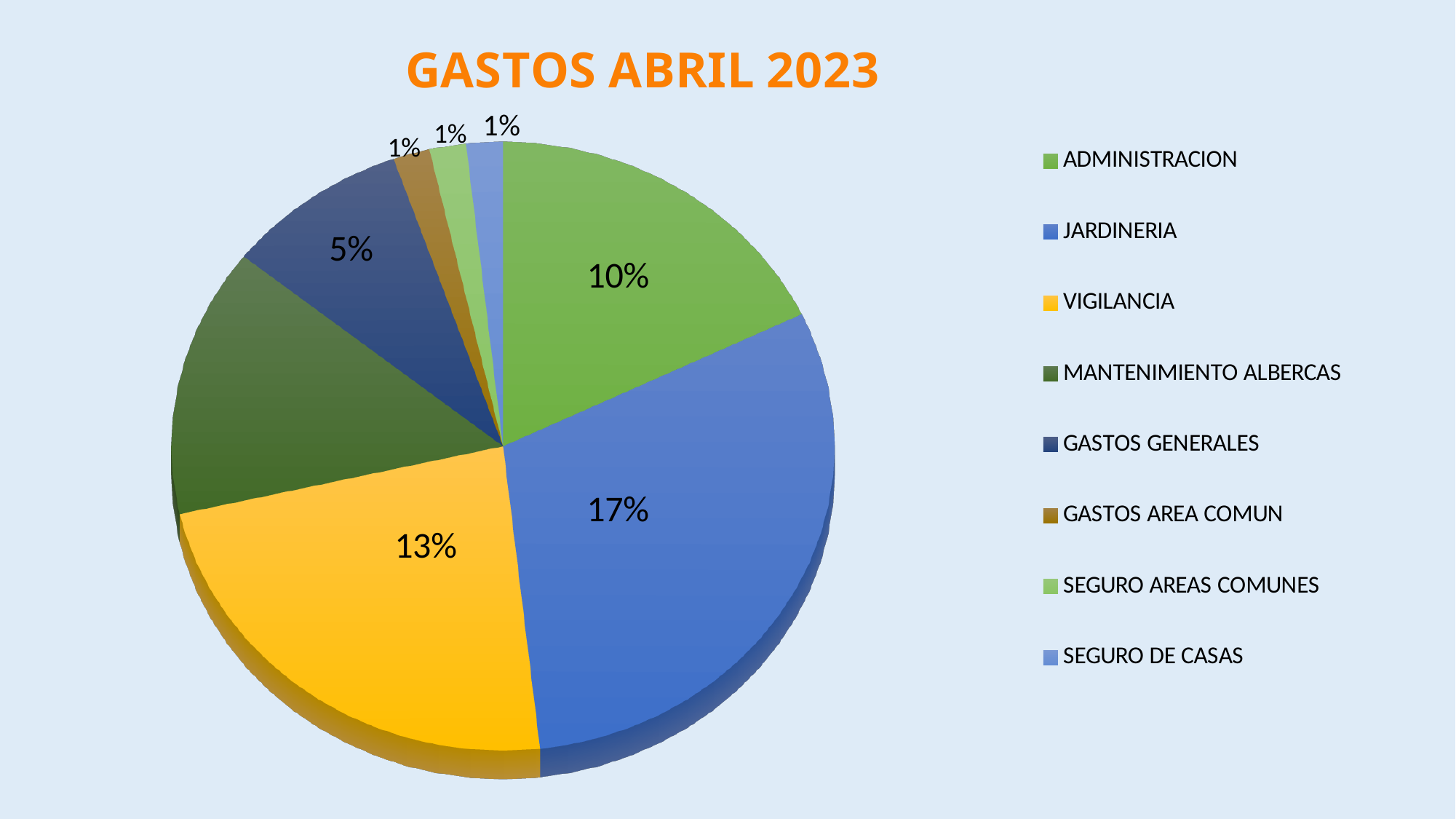
What is the difference in percentage points between JARDINERIA and VIGILANCIA? 4 What type of chart is shown on the slide? pie chart What colour is the slice for VIGILANCIA? yellow Which is larger, the slice for JARDINERIA or the slice for VIGILANCIA? JARDINERIA What percentage is shown for ADMINISTRACION? 10% How many categories are listed in the legend? 8 What percentage is shown for SEGURO DE CASAS? 1% Which category has the largest slice of the pie? JARDINERIA What percentage is shown for JARDINERIA? 17% What is the title of the chart? GASTOS ABRIL 2023 What percentage is shown for GASTOS GENERALES? 5% What percentage is shown for VIGILANCIA? 13%